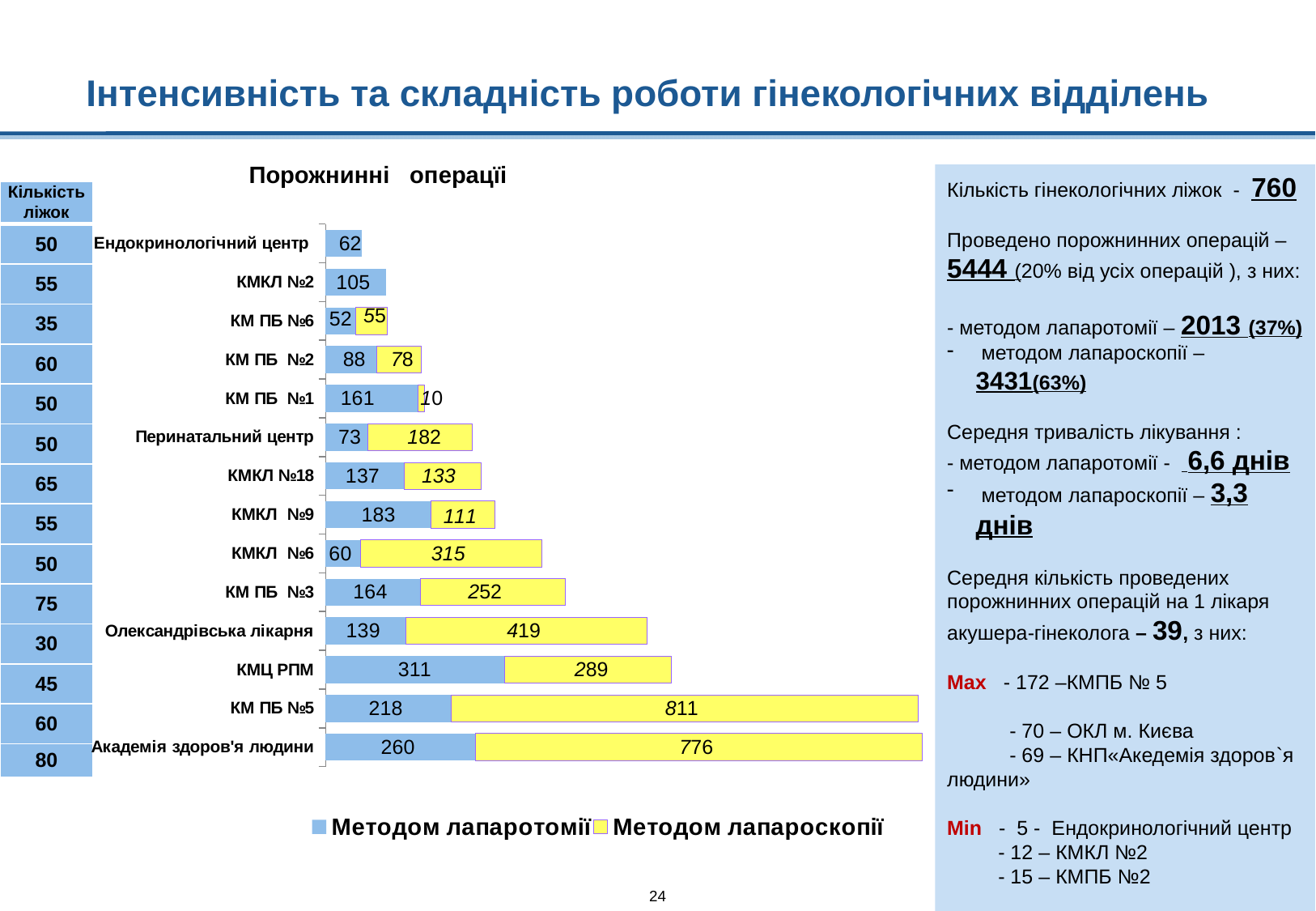
Which is larger for КМКЛ №9: the Методом лапаротомії value or the Методом лапароскопії value? Методом лапаротомії What is the value for Методом лапароскопії for Олександрівська лікарня? 419 Which hospital has the lowest value for Методом лапаротомії? КМ ПБ №6 How many series does the chart legend list? 2 Which hospital has the highest value for Методом лапароскопії? КМ ПБ №5 What is the total of the stacked bar for Академія здоров'я людини? 1036 How many hospitals (categories) are shown in the chart? 14 What is the value for Методом лапаротомії for КМЦ РПМ? 311 What type of chart is shown on the slide? stacked bar chart Which hospital has the highest value for Методом лапаротомії? КМЦ РПМ What is the difference between the Методом лапароскопії values for КМ ПБ №5 and Академія здоров'я людини? 35 What is the value for Методом лапароскопії for КМ ПБ №5? 811